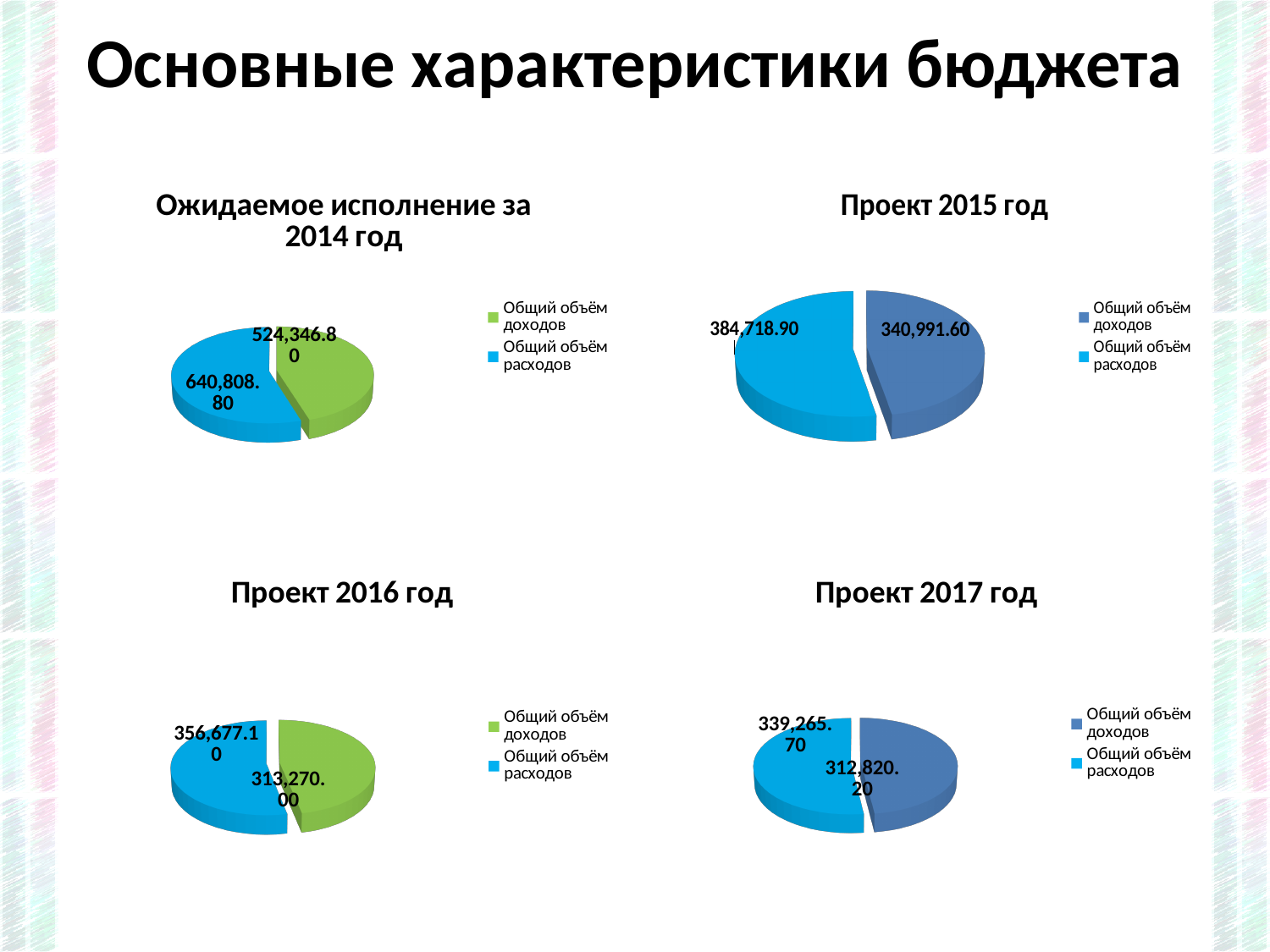
In the pie chart titled 'Ожидаемое исполнение за 2014 год', what is the value for 'Общий объём расходов'? 640,808.80 In the pie chart titled 'Проект 2015 год', what is the value for 'Общий объём доходов'? 340,991.60 In the pie chart titled 'Проект 2015 год', what is the value for 'Общий объём расходов'? 384,718.90 In the pie chart titled 'Проект 2015 год', what is the difference between 'Общий объём расходов' and 'Общий объём доходов'? 43,727.30 What type of chart is used in the 'Проект 2016 год' chart? Pie chart How many pie charts are shown on the slide? 4 In the pie chart titled 'Проект 2017 год', what is the difference between 'Общий объём расходов' and 'Общий объём доходов'? 26,445.50 In the pie chart titled 'Проект 2016 год', what is the value for 'Общий объём расходов'? 356,677.10 How many entries does the legend of the 'Проект 2017 год' chart list? 2 In the pie chart titled 'Ожидаемое исполнение за 2014 год', which slice is larger: 'Общий объём доходов' or 'Общий объём расходов'? Общий объём расходов In the pie chart titled 'Проект 2017 год', what is the value for 'Общий объём доходов'? 312,820.20 In the pie chart titled 'Ожидаемое исполнение за 2014 год', what is the value for 'Общий объём доходов'? 524,346.80